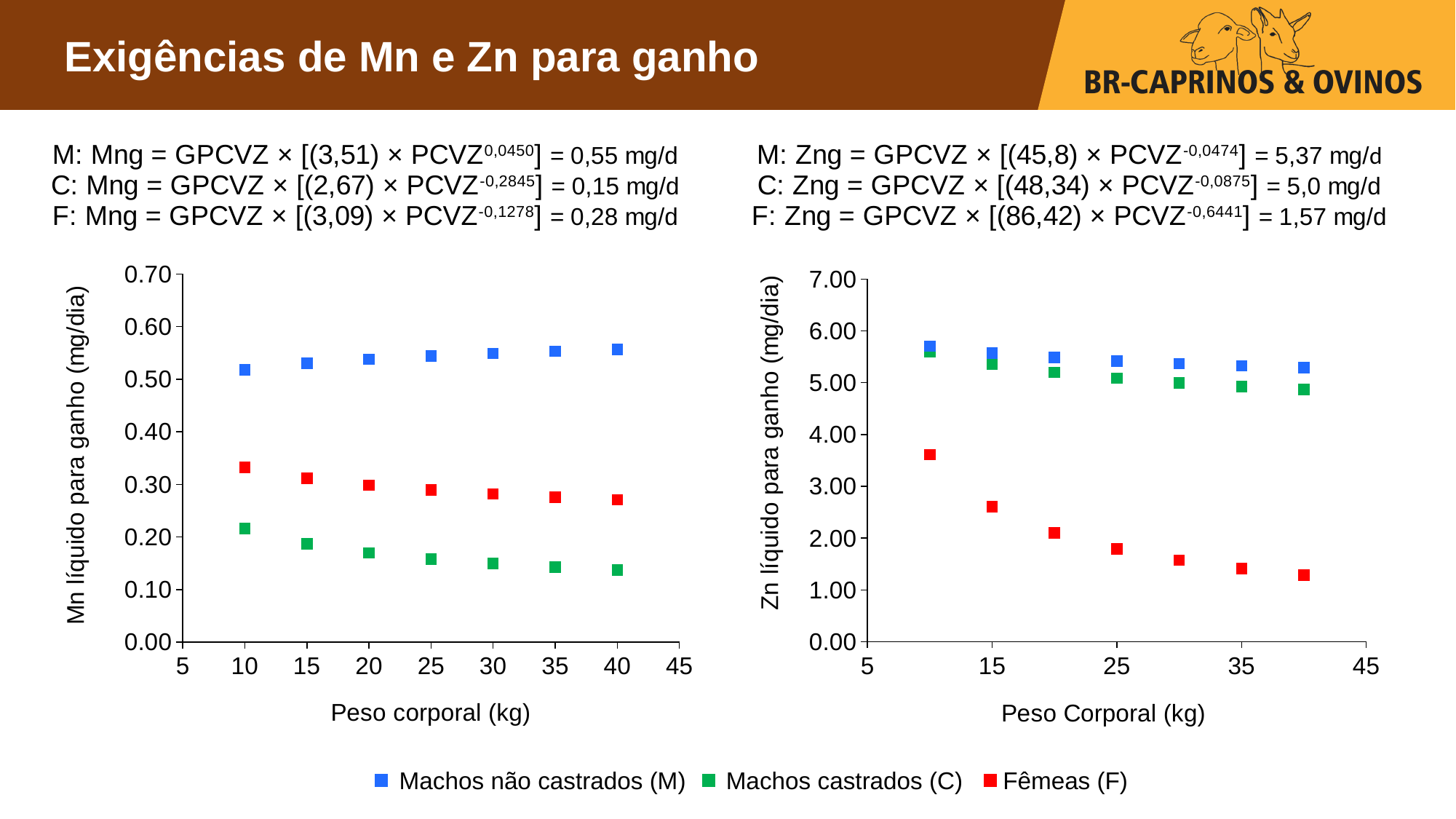
In the right chart (Zn líquido para ganho), which series has the lowest values across all body weights? Fêmeas (F) In the left chart (Mn líquido para ganho), do the values for Machos não castrados (M) rise or fall as body weight increases? rise In the right chart (Zn líquido para ganho), is the value for Fêmeas (F) at 40 kg greater or less than 2.00? less What kind of chart is the left chart (Mn líquido para ganho)? scatter chart What is the x-axis title of the left chart? Peso corporal (kg) In the right chart (Zn líquido para ganho), at 40 kg, which is larger: the value for Machos não castrados (M) or for Fêmeas (F)? Machos não castrados (M) In the left chart (Mn líquido para ganho), which series has the highest values across all body weights? Machos não castrados (M) In the left chart (Mn líquido para ganho), which series has the lowest values across all body weights? Machos castrados (C) In the right chart (Zn líquido para ganho), do the values for Fêmeas (F) rise or fall as body weight increases? fall How many series does the shared legend list? 3 In the left chart (Mn líquido para ganho), is the value for Fêmeas (F) at 10 kg greater or less than 0.30? greater In the right chart (Zn líquido para ganho), how many data points are plotted for Fêmeas (F)? 7